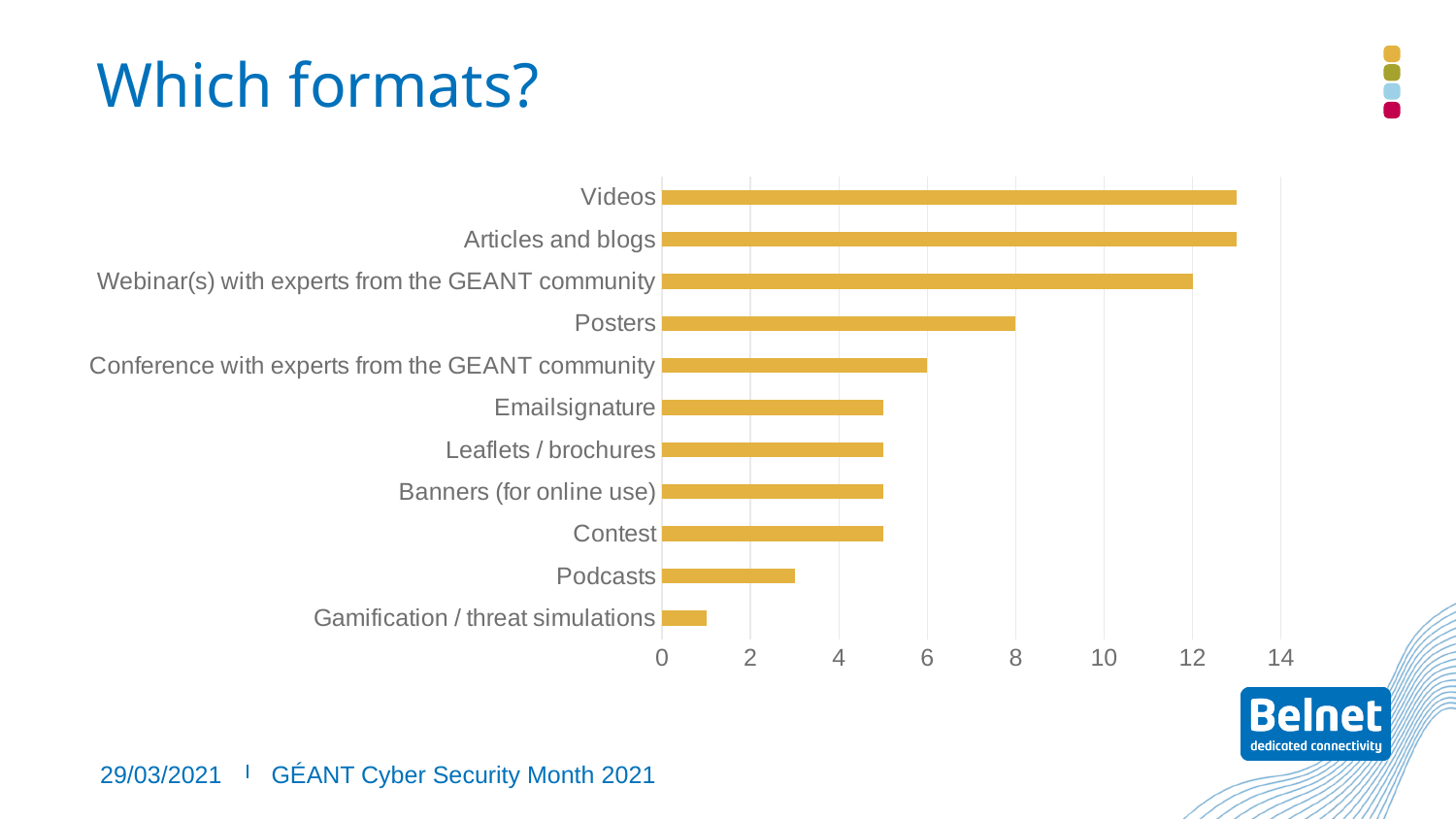
Is the value for Videos greater or less than 12? greater What is the value for Posters? 8 Is the value for Contest greater or less than 4? greater What is the difference between the values for Posters and Conference with experts from the GEANT community? 2 What is the title of the slide containing the chart? Which formats? Is the value for Gamification / threat simulations greater or less than 2? less What kind of chart is shown on the slide? bar chart Which is larger, the value for Posters or the value for Podcasts? Posters Which format has the lowest value? Gamification / threat simulations How many formats (categories) are listed in the chart? 11 What is the value for Conference with experts from the GEANT community? 6 What is the value for Webinar(s) with experts from the GEANT community? 12